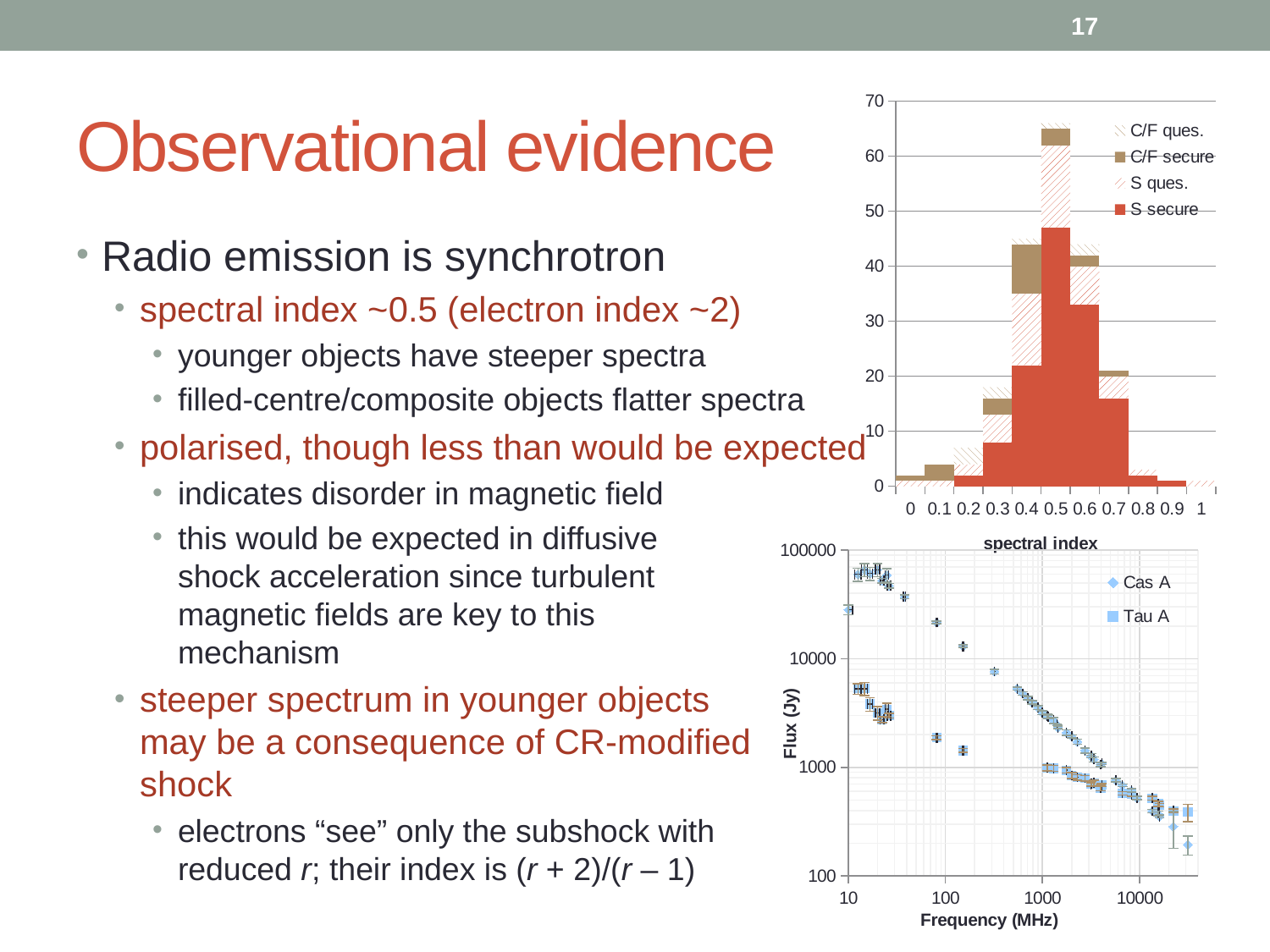
In the top spectral index chart, is the total height of the stacked bar at spectral index 0.1 greater or less than 10? less What kind of chart is the top chart on the slide (the one with the spectral index axis)? bar chart In the bottom Flux vs Frequency chart, does the flux rise or fall as frequency increases? fall In the bottom Flux vs Frequency chart, which series has the higher flux at 1000 MHz, Cas A or Tau A? Cas A How many series does the legend of the top spectral index chart list? 4 In the top spectral index chart, is the total height of the stacked bar at spectral index 0.3 greater or less than 20? less How many series does the legend of the bottom Flux vs Frequency chart list? 2 What is the label of the x axis of the bottom chart on the slide? Frequency (MHz) In the top spectral index chart, is the total height of the stacked bar at spectral index 0.5 greater or less than 60? greater In the top spectral index chart, which spectral index bin has the tallest stacked bar? 0.5 What kind of chart is the bottom chart on the slide (Flux vs Frequency)? scatter chart